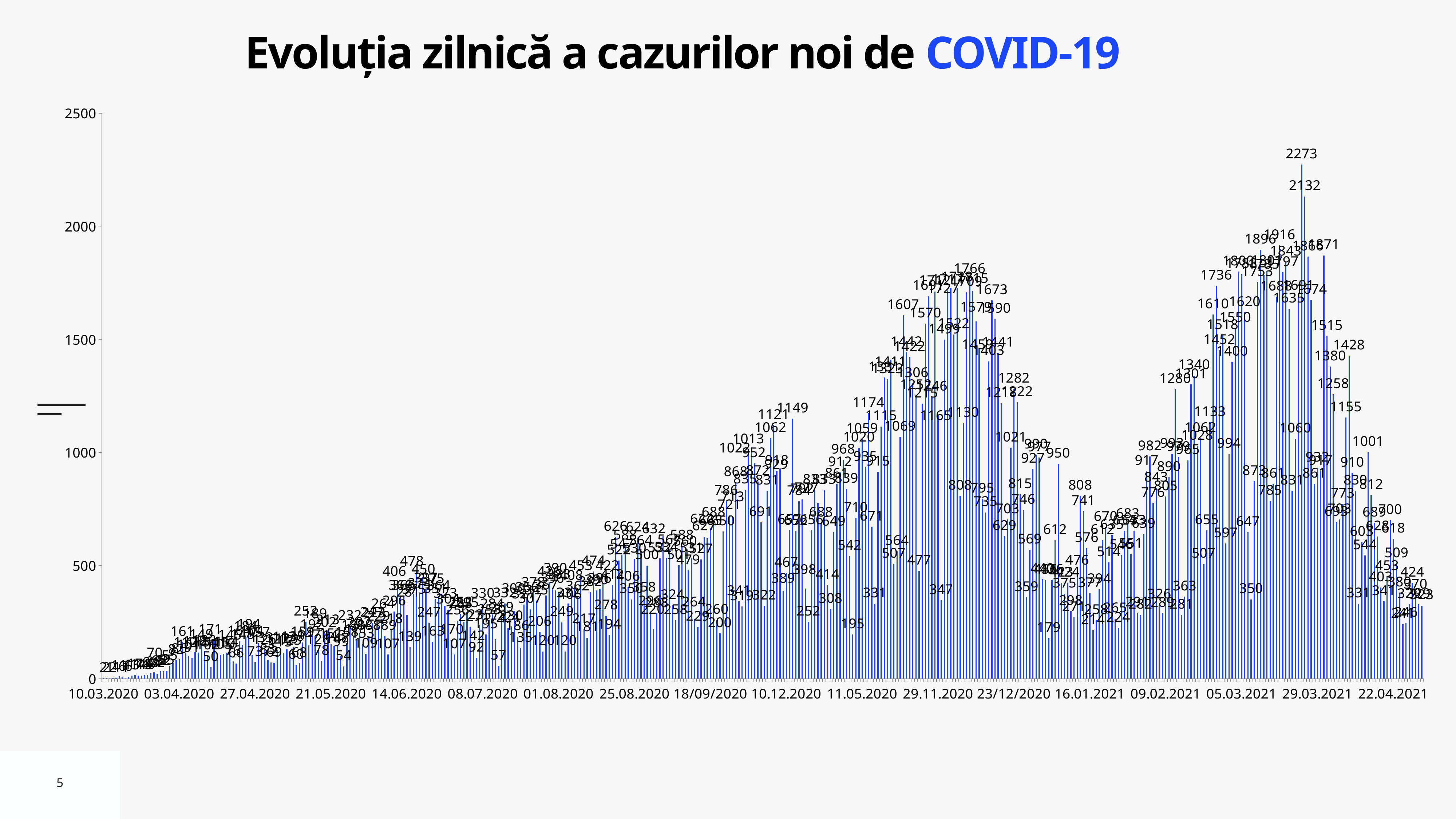
Are the values around 10.03.2020 greater or less than 500? less Which is larger, the peak value of 2273 or the value of 1766 labelled near 29.11.2020? 2273 What is the highest daily value labelled on the chart? 2273 Do the values generally rise or fall between 10.03.2020 and 14.06.2020? rise What is the last date label on the horizontal axis? 22.04.2021 What is the difference between the two highest labelled values, 2273 and 2132? 141 What kind of chart is shown on the slide? bar chart Is the highest value on the chart greater or less than 2000? greater What is the first date label on the horizontal axis? 10.03.2020 What is the maximum value shown on the vertical axis? 2500 What is the title of the chart? Evoluția zilnică a cazurilor noi de COVID-19 What is the second-highest daily value labelled on the chart, just below the 2273 peak? 2132